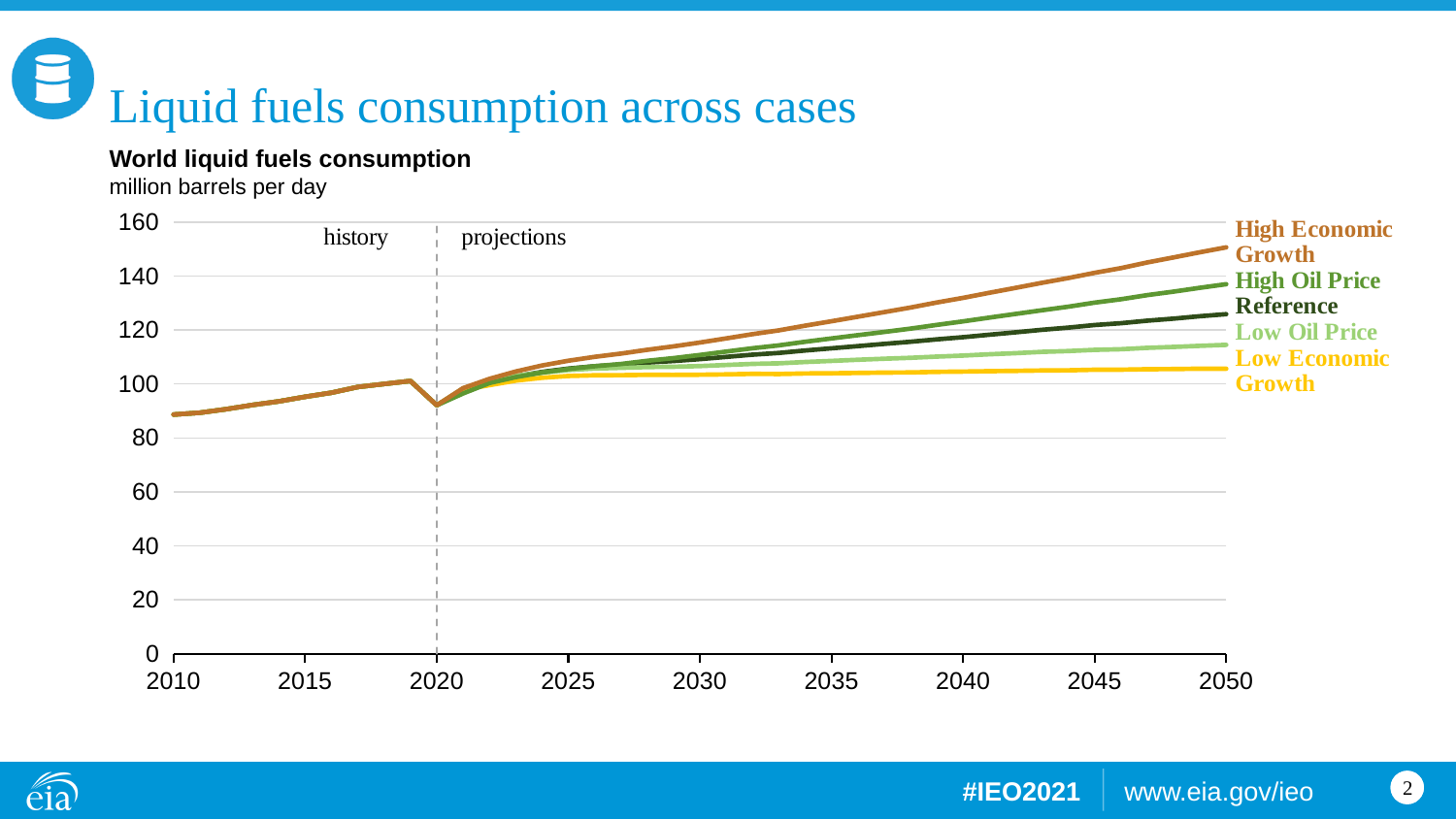
How many cases (series) are labelled on the chart? 5 Is the world liquid fuels consumption in 2010 greater or less than 100? less What unit is the chart measured in? million barrels per day Does the High Economic Growth line rise or fall between 2020 and 2050? rise Is the value for Reference in 2050 greater or less than 120? greater What kind of chart is shown on the slide? line chart Which case has the lowest liquid fuels consumption in 2050? Low Economic Growth What year does the dashed vertical line separating history from projections fall on? 2020 Is the value for Low Oil Price in 2050 greater or less than 120? less Which case has the highest liquid fuels consumption in 2050? High Economic Growth In 2050, which is larger: the Reference case or the Low Oil Price case? Reference